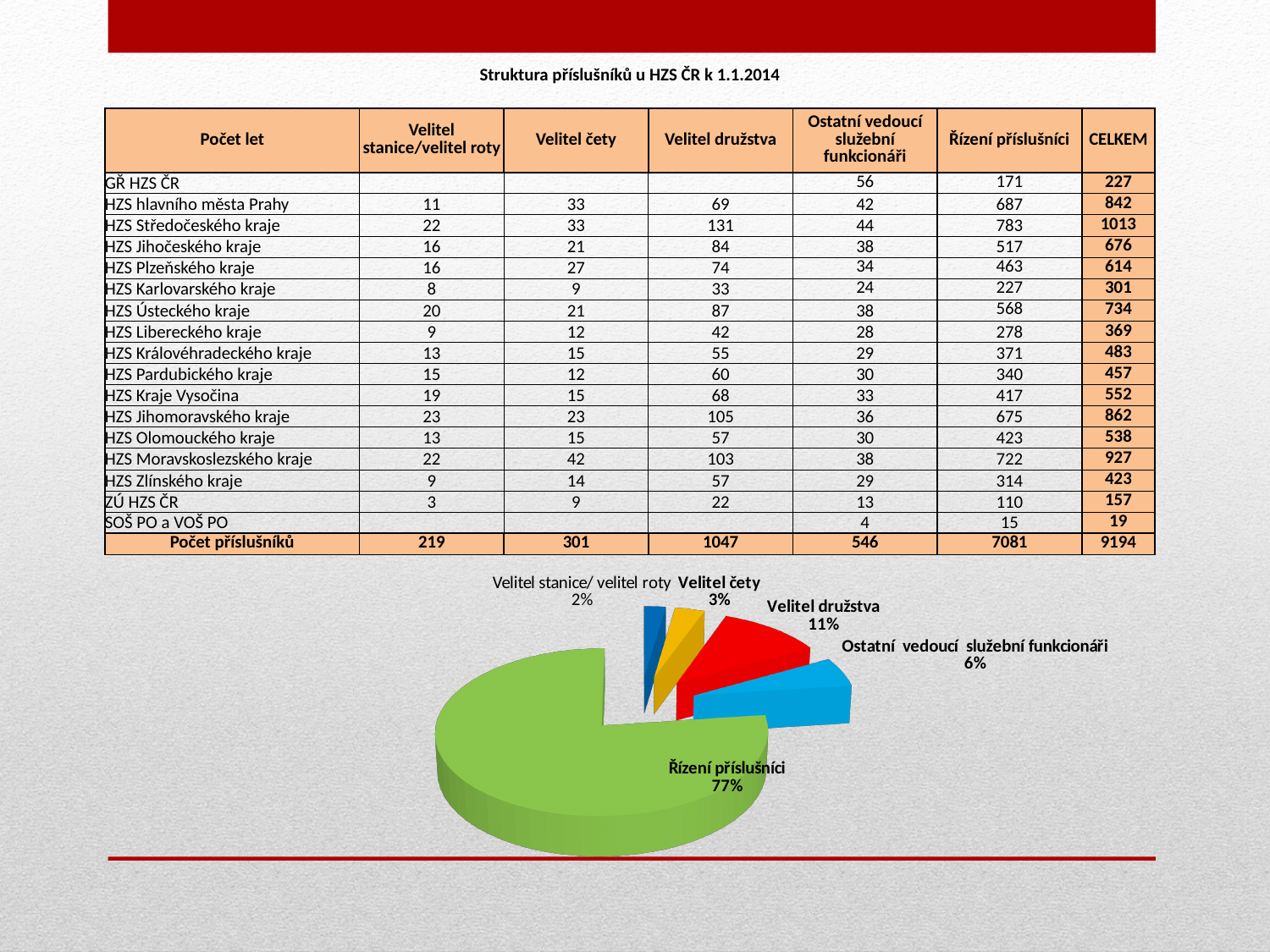
What share of the pie does Velitel družstva have? 11% What colour is the Řízení příslušníci slice of the pie? green Which category has the smallest slice of the pie? Velitel stanice/velitel roty What is the difference in percentage points between the Řízení příslušníci slice and the Velitel družstva slice? 66 Which category has the largest slice of the pie? Řízení příslušníci What share of the pie does Ostatní vedoucí služební funkcionáři have? 6% What share of the pie does Řízení příslušníci have? 77% What kind of chart is shown on the slide? pie chart How many slices does the pie chart have? 5 Which slice is larger, Velitel družstva or Ostatní vedoucí služební funkcionáři? Velitel družstva